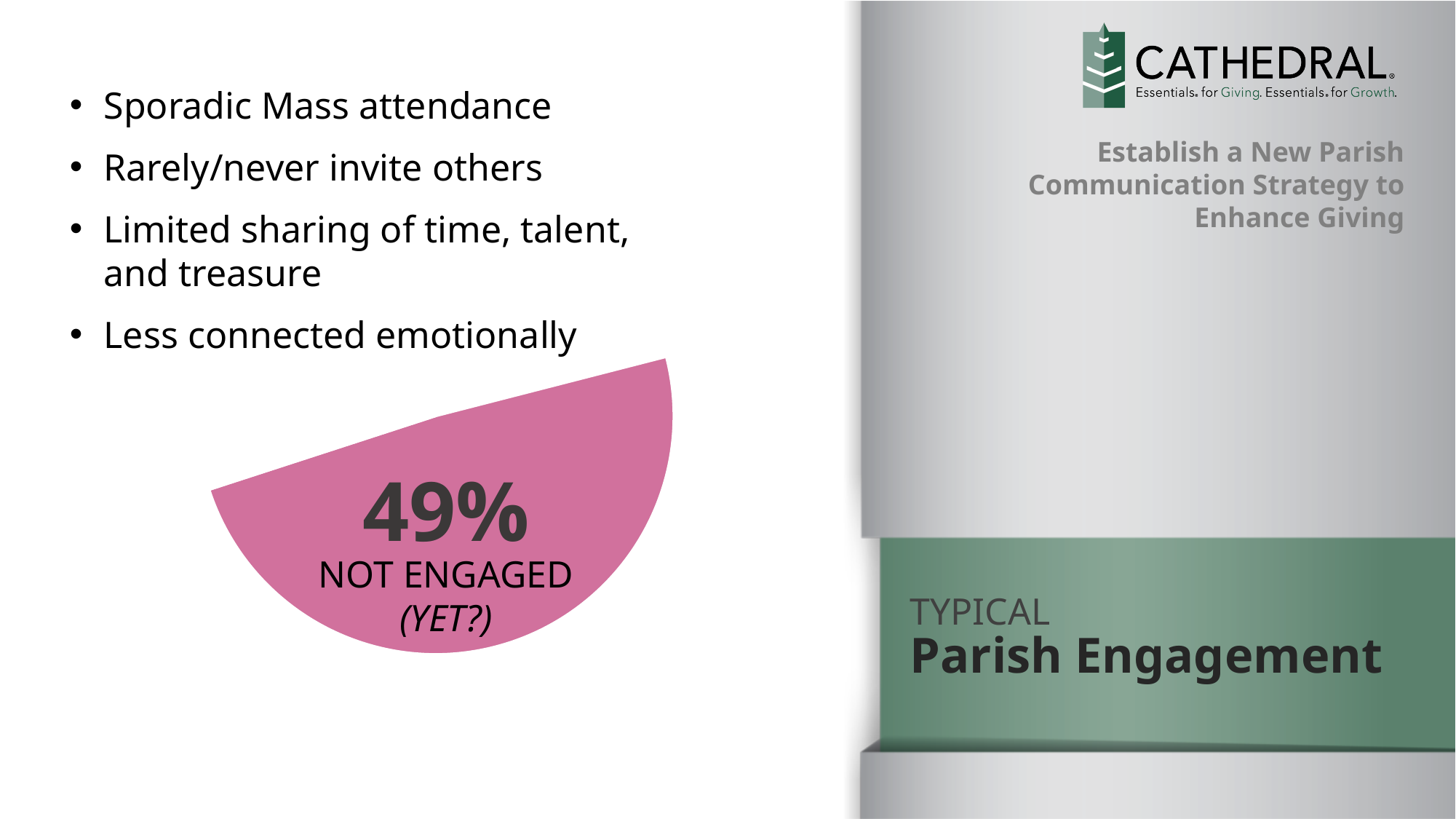
What colour is the NOT ENGAGED slice? pink What category label is printed on the pink slice? NOT ENGAGED What share of the pie does the NOT ENGAGED slice represent? 49% What kind of chart is the pink shape on the slide? pie chart What word in italics appears below NOT ENGAGED on the slice? (YET?) How many slices of the pie chart are visible on the slide? 1 What percentage is shown on the pink pie slice? 49%